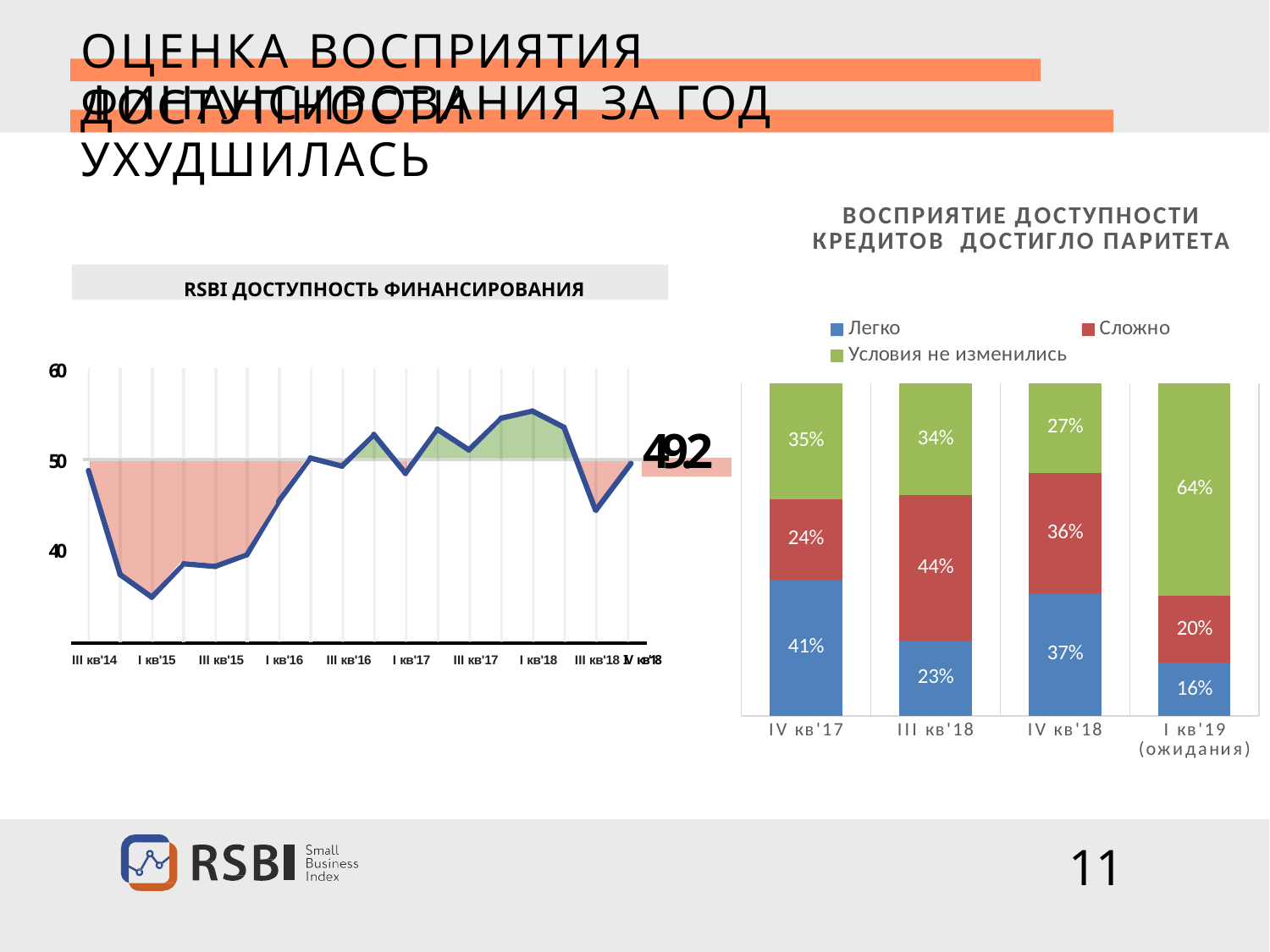
How many categories are shown on the x axis of the right chart? 4 In the right chart, is the Легко value for IV кв'17 larger or smaller than the Легко value for III кв'18? larger In the right chart, what is the difference between Сложно and Легко for III кв'18? 21% How many series does the legend of the right chart list? 3 In the right chart, what is the value of Условия не изменились for I кв'19 (ожидания)? 64% In the right chart, what is the value of Сложно for III кв'18? 44% In the left chart (RSBI ДОСТУПНОСТЬ ФИНАНСИРОВАНИЯ), is the value for I кв'15 greater or less than 40? less In the right chart (ВОСПРИЯТИЕ ДОСТУПНОСТИ КРЕДИТОВ), what is the value of Легко for IV кв'17? 41% What kind of chart is the left chart titled RSBI ДОСТУПНОСТЬ ФИНАНСИРОВАНИЯ? line chart In the right chart, what is the value of Легко for IV кв'18? 37% In the right chart, which category has the highest value for Сложно? III кв'18 In the right chart, which category has the lowest value for Легко? I кв'19 (ожидания)